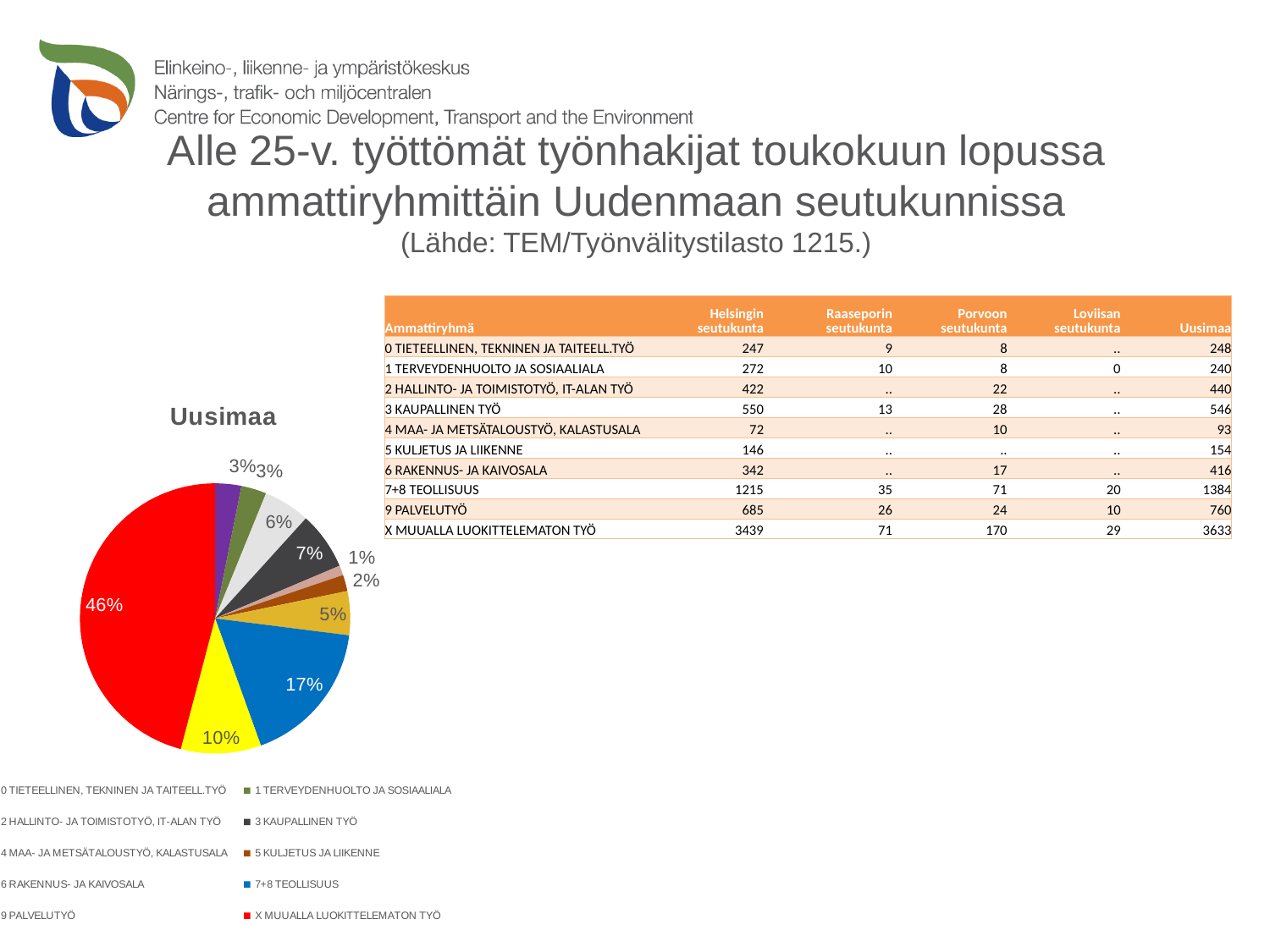
What kind of chart is shown on the slide? pie chart What share of the pie does the brown slice (5 KULJETUS JA LIIKENNE) represent? 2% What share of the pie does the blue slice (7+8 TEOLLISUUS) represent? 17% How many slices does the pie chart have? 10 How many entries does the legend of the pie chart list? 10 What is the largest share shown in the pie chart? 46% What colour is the largest slice of the pie chart? red What is the smallest share shown in the pie chart? 1% What is the title of the pie chart? Uusimaa What is the difference in percentage points between the 46% slice and the 17% slice? 29 percentage points What share of the pie does the red slice (X MUUALLA LUOKITTELEMATON TYÖ) represent? 46% Which slice is larger, the red slice (X MUUALLA LUOKITTELEMATON TYÖ) or the blue slice (7+8 TEOLLISUUS)? the red slice (X MUUALLA LUOKITTELEMATON TYÖ)